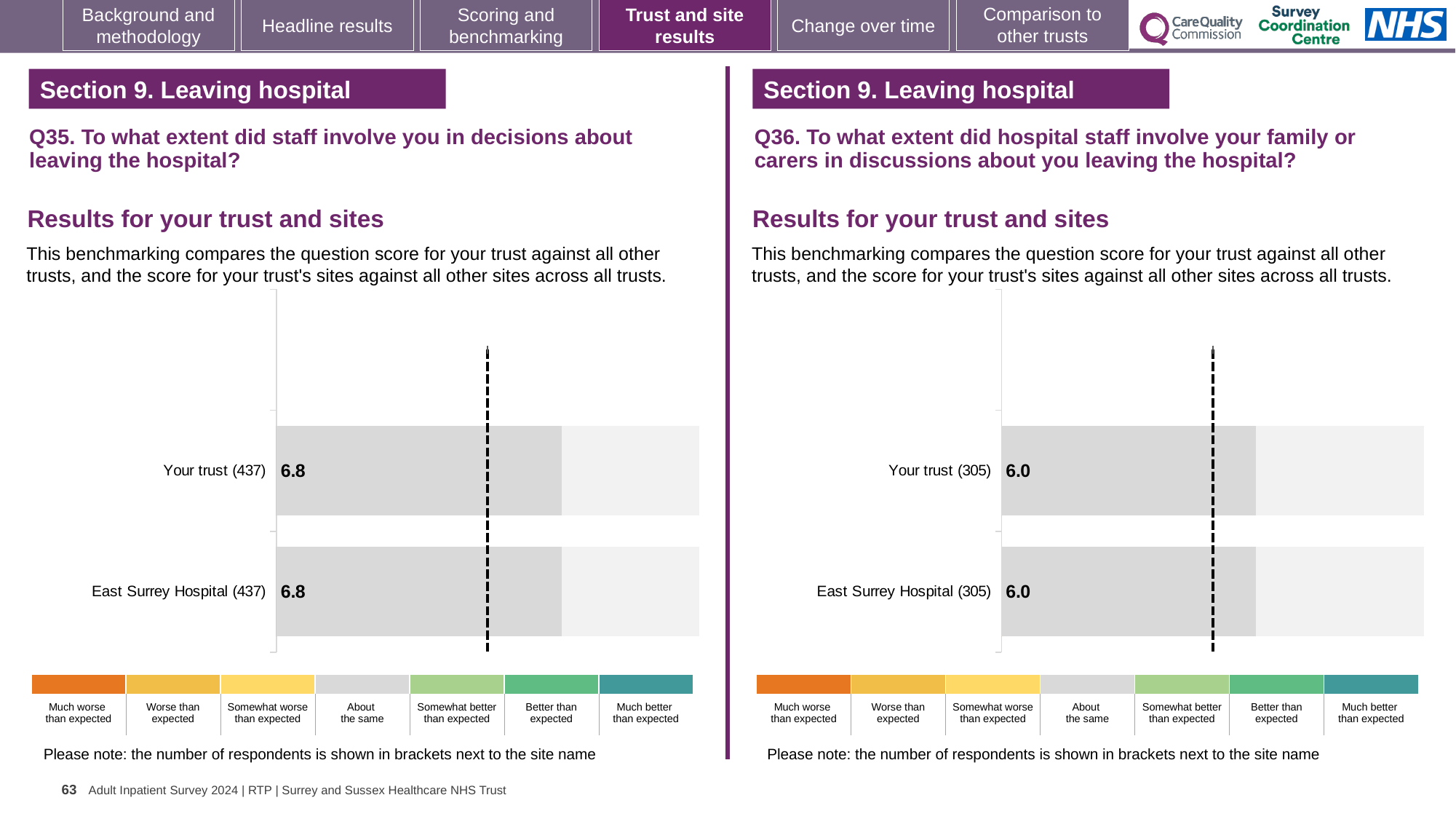
In the Q36 chart on the right, which benchmark category does the grey colour of the bars correspond to in the legend? About the same How many bars are plotted in the Q36 chart on the right? 2 How many bars are plotted in the Q35 chart on the left? 2 In the Q35 chart on the left, how many respondents are shown in brackets for Your trust? 437 What kind of chart is used for the Q35 results on the left? Bar chart In the Q36 chart on the right, what is the score for Your trust? 6.0 In the Q35 chart on the left, what is the score for East Surrey Hospital? 6.8 Which is larger: the Your trust score in the Q35 chart on the left or the Your trust score in the Q36 chart on the right? Q35 chart (6.8) In the Q36 chart on the right, how many respondents are shown in brackets for East Surrey Hospital? 305 In the Q36 chart on the right, what is the score for East Surrey Hospital? 6.0 In the Q35 chart on the left, what is the score for Your trust? 6.8 What is the difference between the East Surrey Hospital score in the Q35 chart on the left and the East Surrey Hospital score in the Q36 chart on the right? 0.8